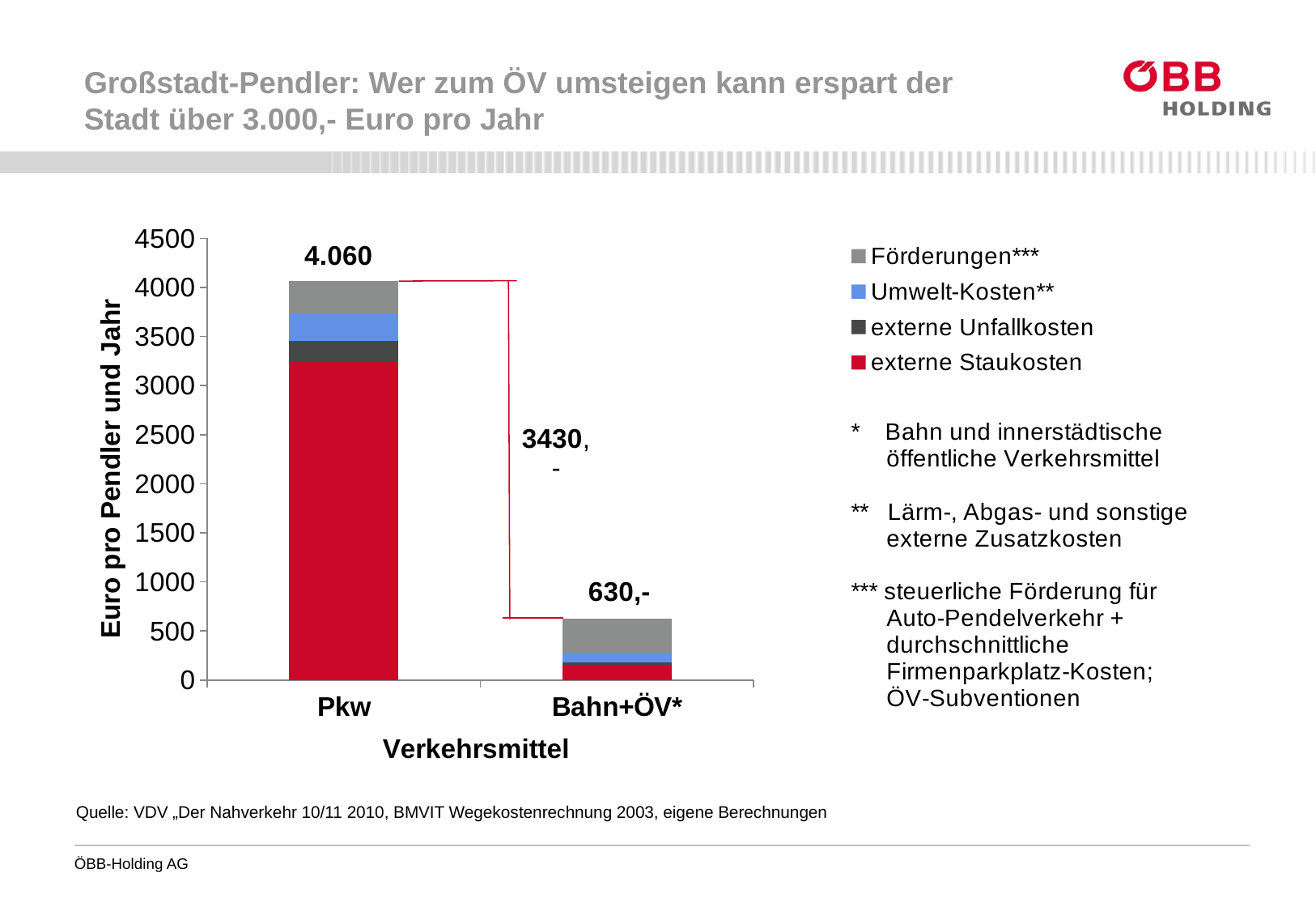
Which category has the lowest total? Bahn+ÖV* What is the total value labelled on the Pkw bar? 4.060 How many categories are shown on the x axis? 2 How many series does the legend list? 4 Which category has the highest total? Pkw Is the externe Staukosten segment of the Pkw bar greater or less than 3000? greater What is the total value labelled on the Bahn+ÖV* bar? 630,- What kind of chart is shown on the slide? Stacked bar chart Is the total for Bahn+ÖV* greater or less than 1000? less What is the title of the y axis? Euro pro Pendler und Jahr What difference between the Pkw and Bahn+ÖV* bars is annotated on the chart? 3430,- Which is larger, the total for Pkw or the total for Bahn+ÖV*? Pkw